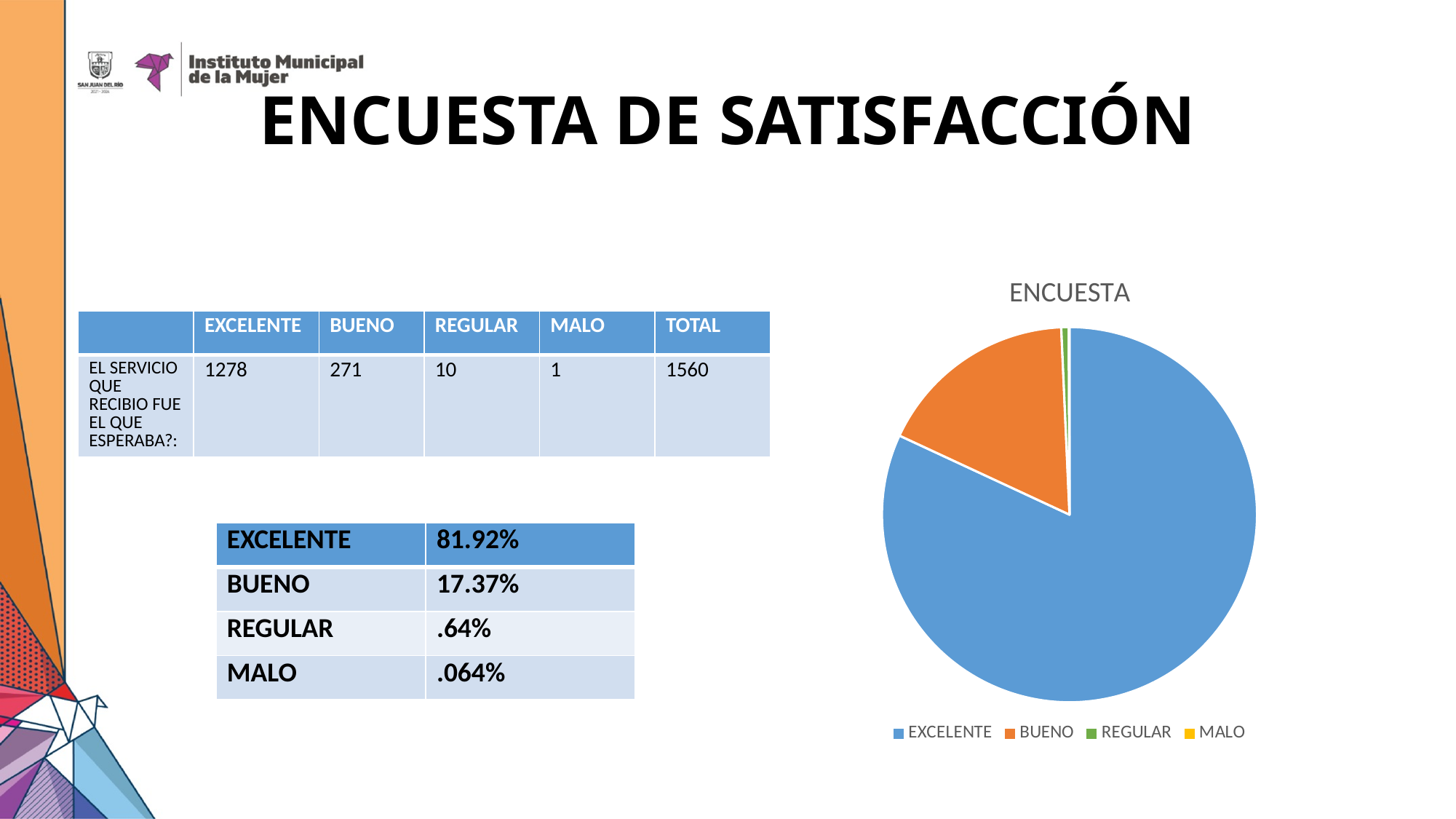
According to the slide, how many responses were BUENO? 271 Which slice is larger, BUENO or REGULAR? BUENO What share of the pie does EXCELENTE represent, as printed on the slide? 81.92% What kind of chart is shown on the slide? pie chart What is the total number of responses shown on the slide? 1560 How many categories does the chart's legend list? 4 What is the title of the chart? ENCUESTA Which category has the largest slice of the pie? EXCELENTE What is the difference between the EXCELENTE and BUENO response counts? 1007 Which category has the smallest slice of the pie? MALO According to the slide, how many responses were EXCELENTE? 1278 What share of the pie does BUENO represent, as printed on the slide? 17.37%